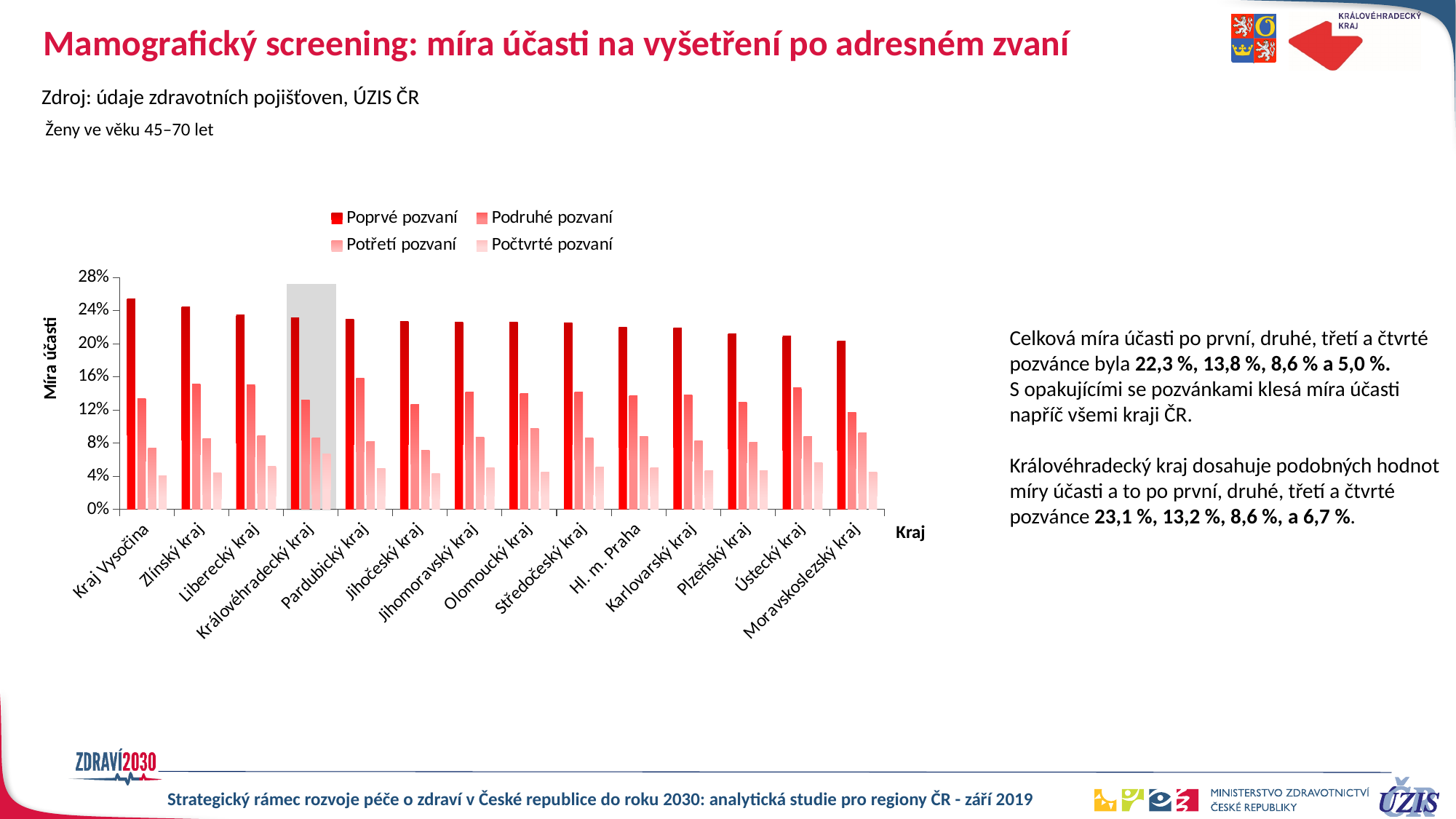
Which is larger: the Podruhé pozvaní value for Zlínský kraj or for Jihočeský kraj? Zlínský kraj Is the Podruhé pozvaní value for Zlínský kraj greater or less than 12%? greater How many series does the legend list? 4 Do the Poprvé pozvaní values generally rise or fall from left to right along the x axis? fall Is the Poprvé pozvaní value for Kraj Vysočina greater or less than 24%? greater Which region has the highest value for Poprvé pozvaní? Kraj Vysočina Which region has the lowest value for Poprvé pozvaní? Moravskoslezský kraj Is the Poprvé pozvaní value for Moravskoslezský kraj greater or less than 24%? less Which region has the lowest value for Podruhé pozvaní? Moravskoslezský kraj What is the label of the y axis? Míra účasti What kind of chart is shown on the slide? bar chart How many regions (kraje) are shown on the x axis? 14